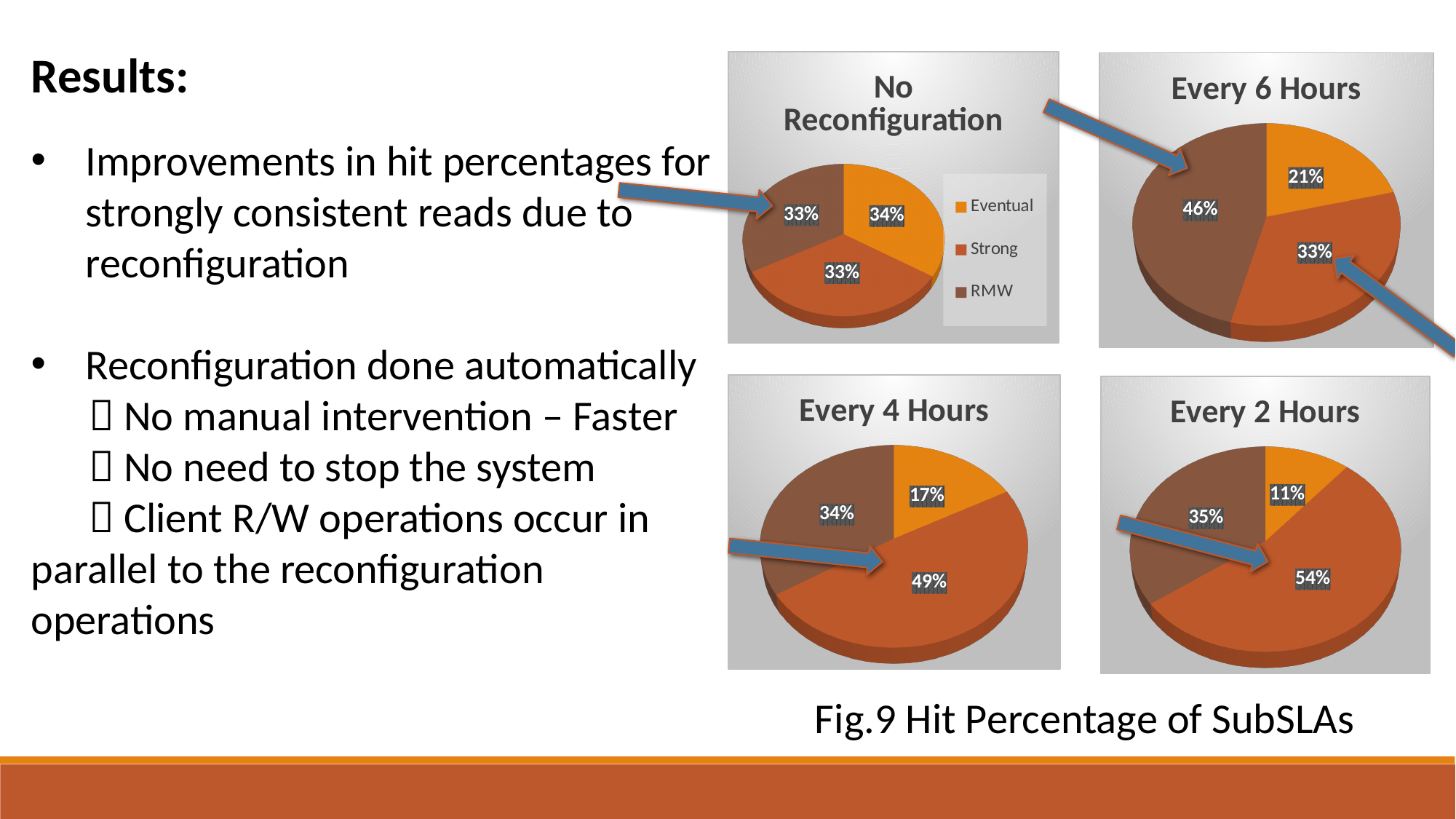
What kind of chart is the "Every 2 Hours" chart? Pie chart How many series does the legend in the "No Reconfiguration" chart list? 3 In the "Every 6 Hours" chart, what is the value for RMW? 46% In the "Every 4 Hours" chart, what is the difference between the Strong and Eventual values? 32% In the "Every 2 Hours" chart, which category has the largest share? Strong In the "Every 4 Hours" chart, what is the value for Strong? 49% What is the title of the pie chart in the bottom-left position? Every 4 Hours In the "Every 6 Hours" chart, which is larger, RMW or Strong? RMW How many pie charts are shown on the slide? 4 In the "Every 2 Hours" chart, what is the value for Eventual? 11% In the "No Reconfiguration" chart, what is the value for Eventual? 34% In the "Every 6 Hours" chart, which category has the smallest share? Eventual